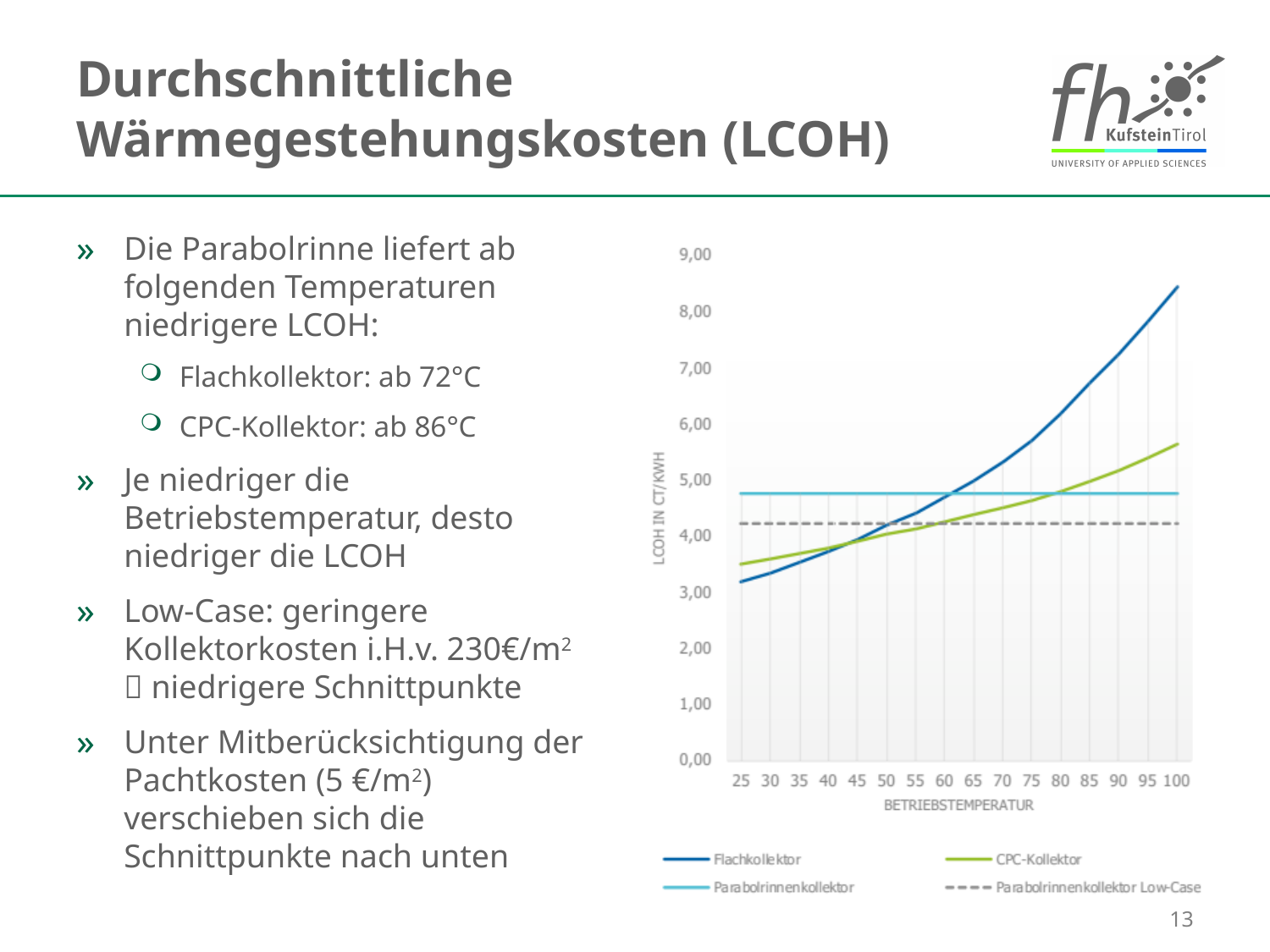
How many series does the chart legend list? 4 How many temperature values are marked on the x axis of the chart? 16 Does the Flachkollektor line rise or fall as the Betriebstemperatur increases? Rises Which series has the highest LCOH at a Betriebstemperatur of 100? Flachkollektor What is the label of the y axis of the chart? LCOH IN CT/KWH At a Betriebstemperatur of 100, which has the higher LCOH: Flachkollektor or CPC-Kollektor? Flachkollektor Which series has the lowest LCOH at a Betriebstemperatur of 100? Parabolrinnenkollektor Low-Case Is the LCOH of the Flachkollektor at a Betriebstemperatur of 25 greater or less than 4,00? less What is the label of the x axis of the chart? BETRIEBSTEMPERATUR What kind of chart is shown on the slide? Line chart Is the LCOH of the Parabolrinnenkollektor Low-Case greater or less than 5,00? less Is the LCOH of the Flachkollektor at a Betriebstemperatur of 100 greater or less than 8,00? greater